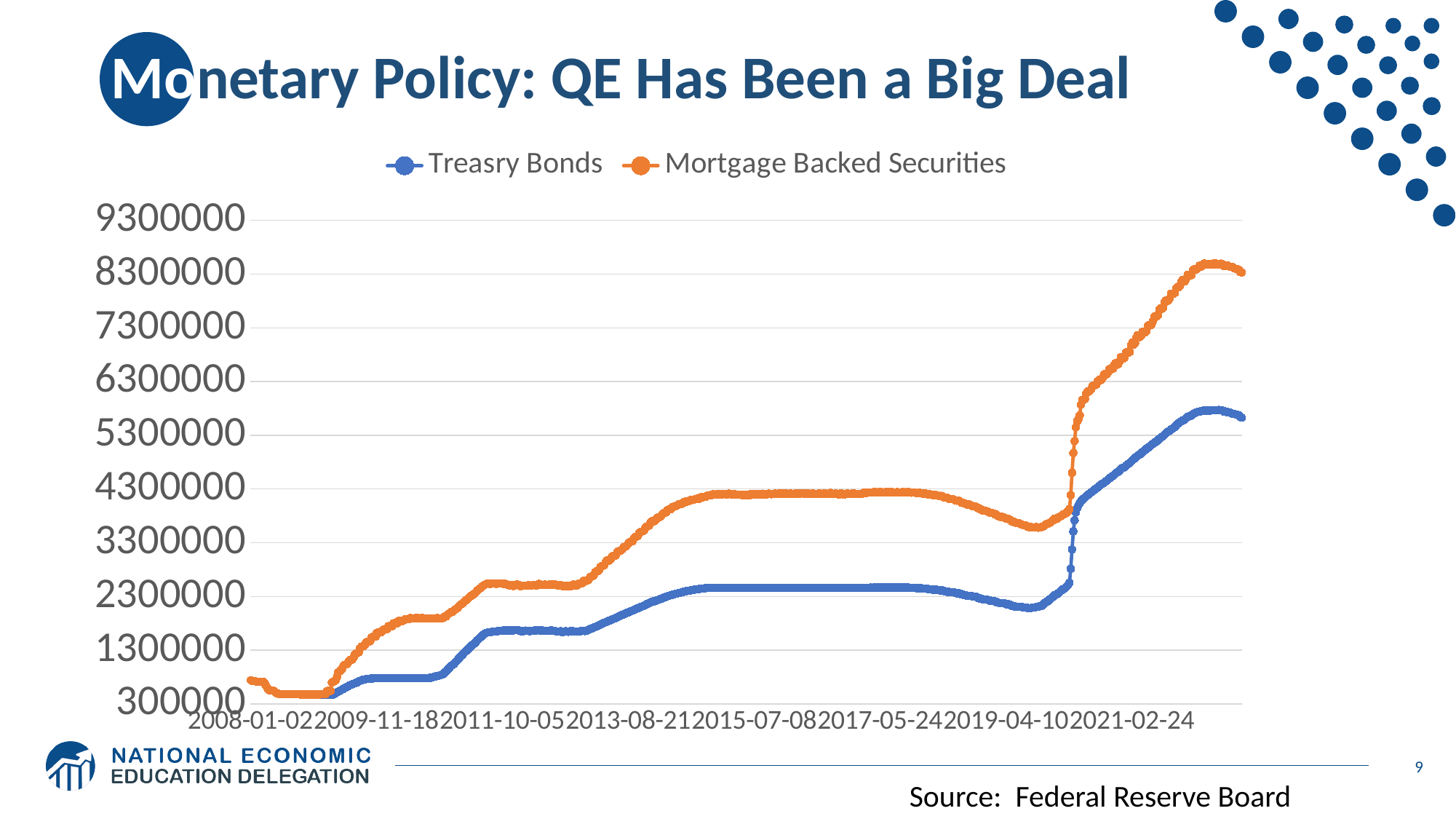
What kind of chart is shown on the slide? Line chart Is the final value of the Treasry Bonds series greater or less than 5300000? greater At 2008-01-02, is the value for Mortgage Backed Securities greater or less than 1300000? less How many series does the chart's legend list? 2 What is the title of the slide containing the chart? Monetary Policy: QE Has Been a Big Deal What are the two series named in the chart's legend? Treasry Bonds and Mortgage Backed Securities Overall, does the Treasry Bonds series rise or fall from the left of the chart to the right? Rise Around 2017-05-24, is the value for Treasry Bonds greater or less than 3300000? less